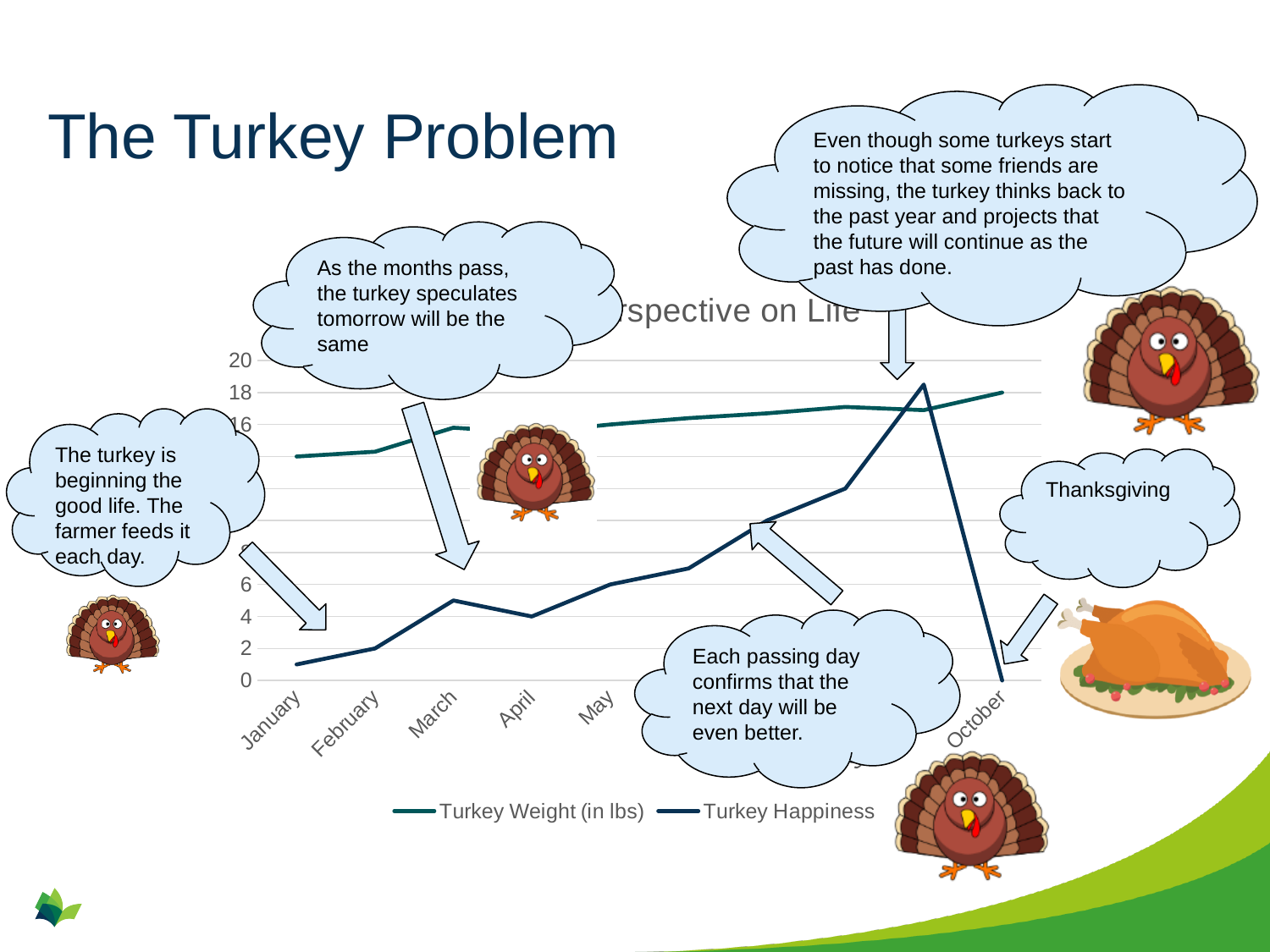
Is the Turkey Happiness value for January greater or less than 2? less Does the Turkey Weight (in lbs) line generally rise or fall from January to October? rise Does the Turkey Happiness line rise or fall between its peak and October? fall In January, which series has the higher value, Turkey Weight (in lbs) or Turkey Happiness? Turkey Weight (in lbs) Is the Turkey Weight (in lbs) value for October greater or less than 16? greater Is the Turkey Weight (in lbs) value for January greater or less than 10? greater In October, which series has the higher value, Turkey Weight (in lbs) or Turkey Happiness? Turkey Weight (in lbs) What kind of chart is shown on the slide? line chart What are the two series named in the chart's legend? Turkey Weight (in lbs) and Turkey Happiness How many series does the chart's legend list? 2